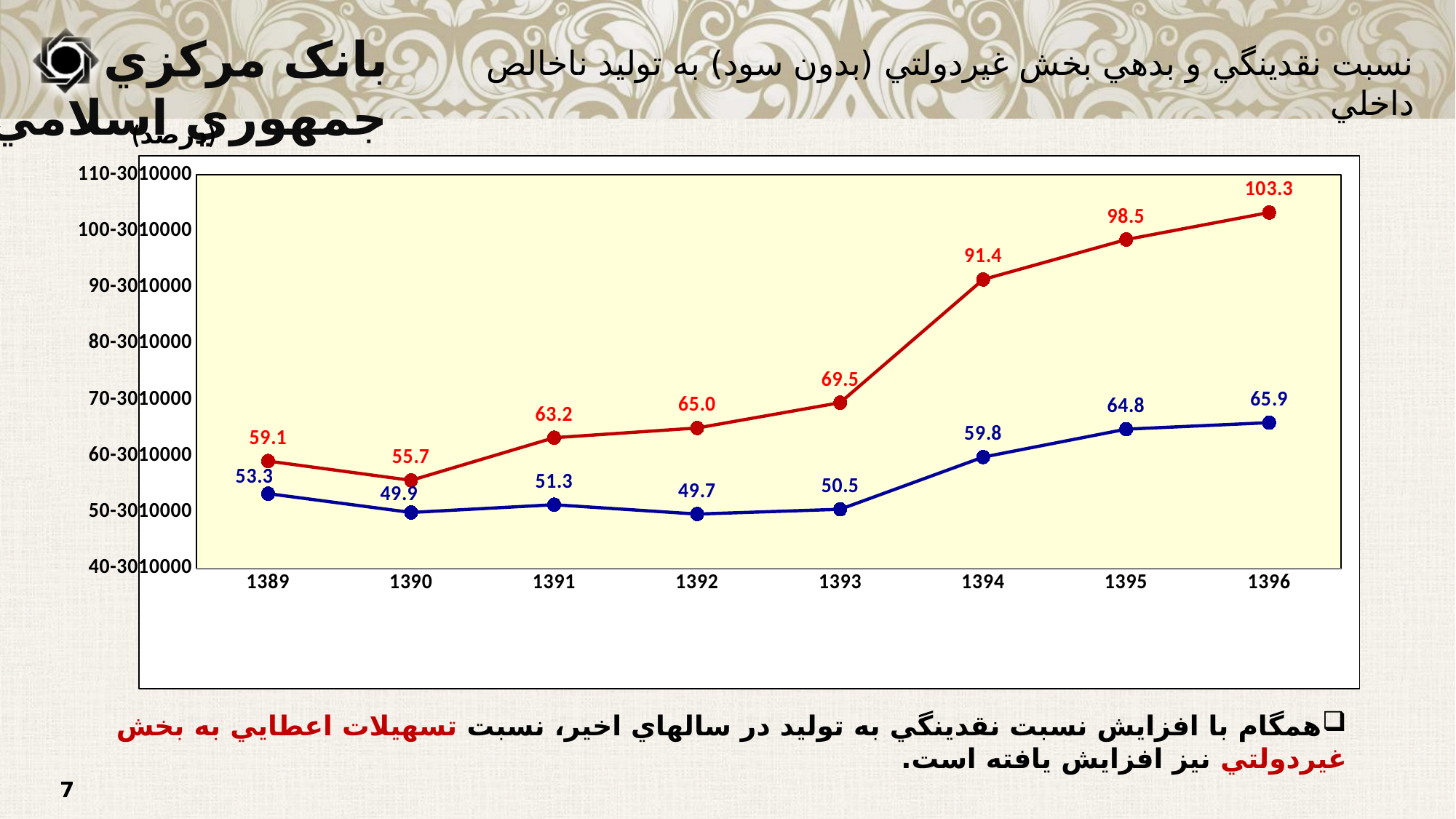
What is the value of the red line in 1396? 103.3 How many years are shown on the x axis? 8 What is the value of the red line in 1389? 59.1 In which year does the blue line have its lowest value? 1392 Which line has the higher value in 1393, the red line or the blue line? the red line In which year does the red line have its lowest value? 1390 What is the value of the blue line in 1392? 49.7 What is the value of the blue line in 1395? 64.8 In which year does the red line reach its highest value? 1396 What is the difference between the red line and the blue line in 1394? 31.6 What type of chart is shown on the slide? line chart Does the red line generally rise or fall from 1390 to 1396? rise